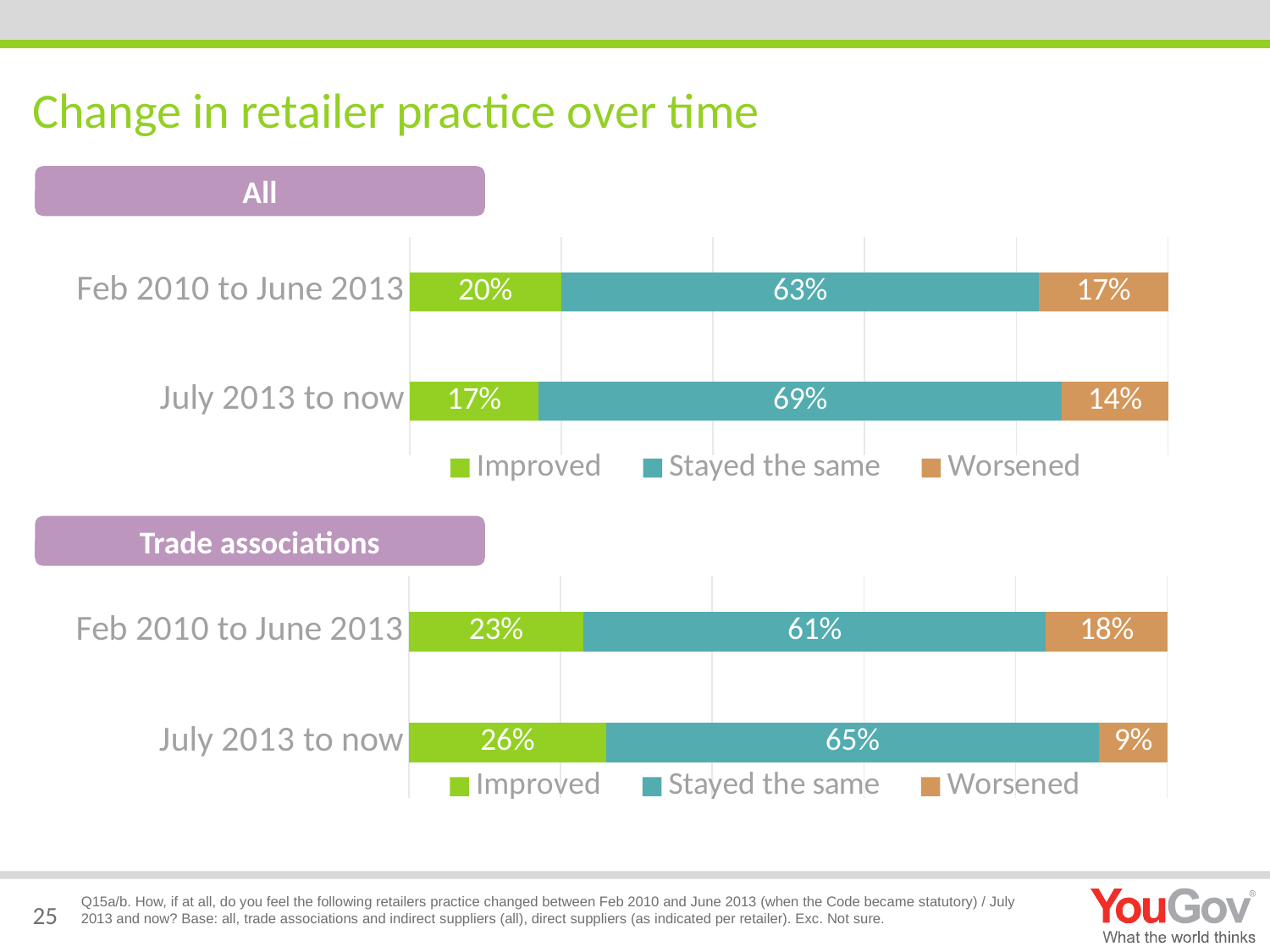
In the 'Trade associations' chart, what percentage said retailer practice improved from Feb 2010 to June 2013? 23% What colour represents 'Worsened' in the charts? Orange In the 'Trade associations' chart, what is the total of the stacked bar for July 2013 to now? 100% In the 'All' chart, what percentage said retailer practice stayed the same from July 2013 to now? 69% In the 'Trade associations' chart, which period has the larger 'Improved' value, Feb 2010 to June 2013 or July 2013 to now? July 2013 to now In the 'Trade associations' chart, what percentage said retailer practice worsened from July 2013 to now? 9% In the 'All' chart, which period has the larger 'Stayed the same' value? July 2013 to now How many series does the legend of the 'All' chart list? 3 How many periods (categories) are shown in the 'Trade associations' chart? 2 In the 'All' chart, what is the difference between the 'Worsened' values for Feb 2010 to June 2013 and July 2013 to now? 3 percentage points In the 'All' chart, what percentage said retailer practice improved from Feb 2010 to June 2013? 20% What kind of chart is the 'All' chart? Stacked bar chart